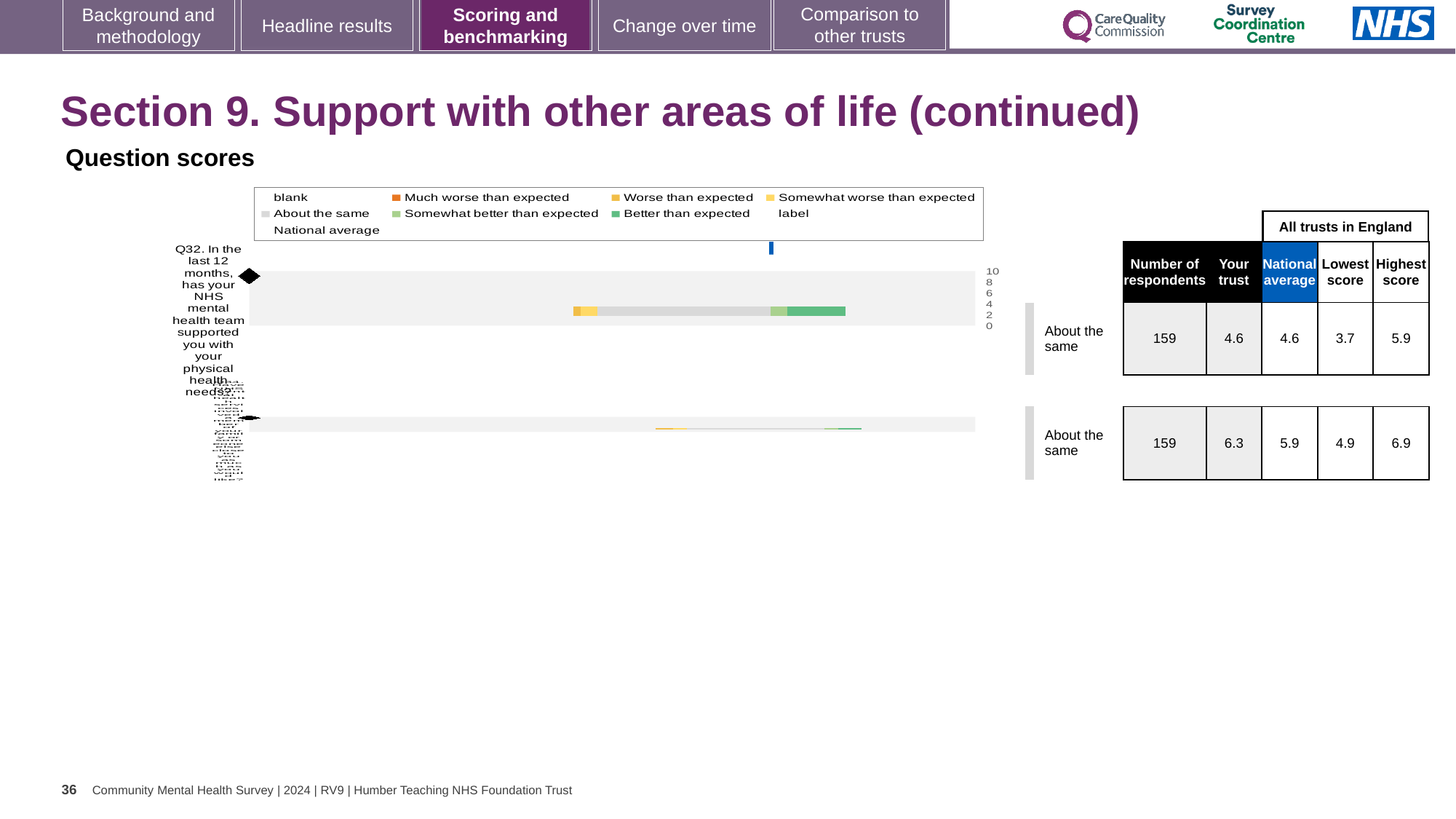
Is the trust's score for Q32 higher than, lower than, or the same as the national average? the same How many respondents answered Q32? 159 What is the highest score among all trusts in England for Q32? 5.9 What is the national average score for Q32? 4.6 What is the difference between the highest and lowest trust scores for Q32? 2.2 What benchmark category is shown for Q32? About the same What is the lowest score among all trusts in England for Q32? 3.7 By how much does the trust's score for Q32 exceed the lowest score in England? 0.9 What is the 'Your trust' score for Q32 (support with physical health needs)? 4.6 What type of chart is used to show the question scores? bar chart What is the maximum value shown on the chart's score axis? 10